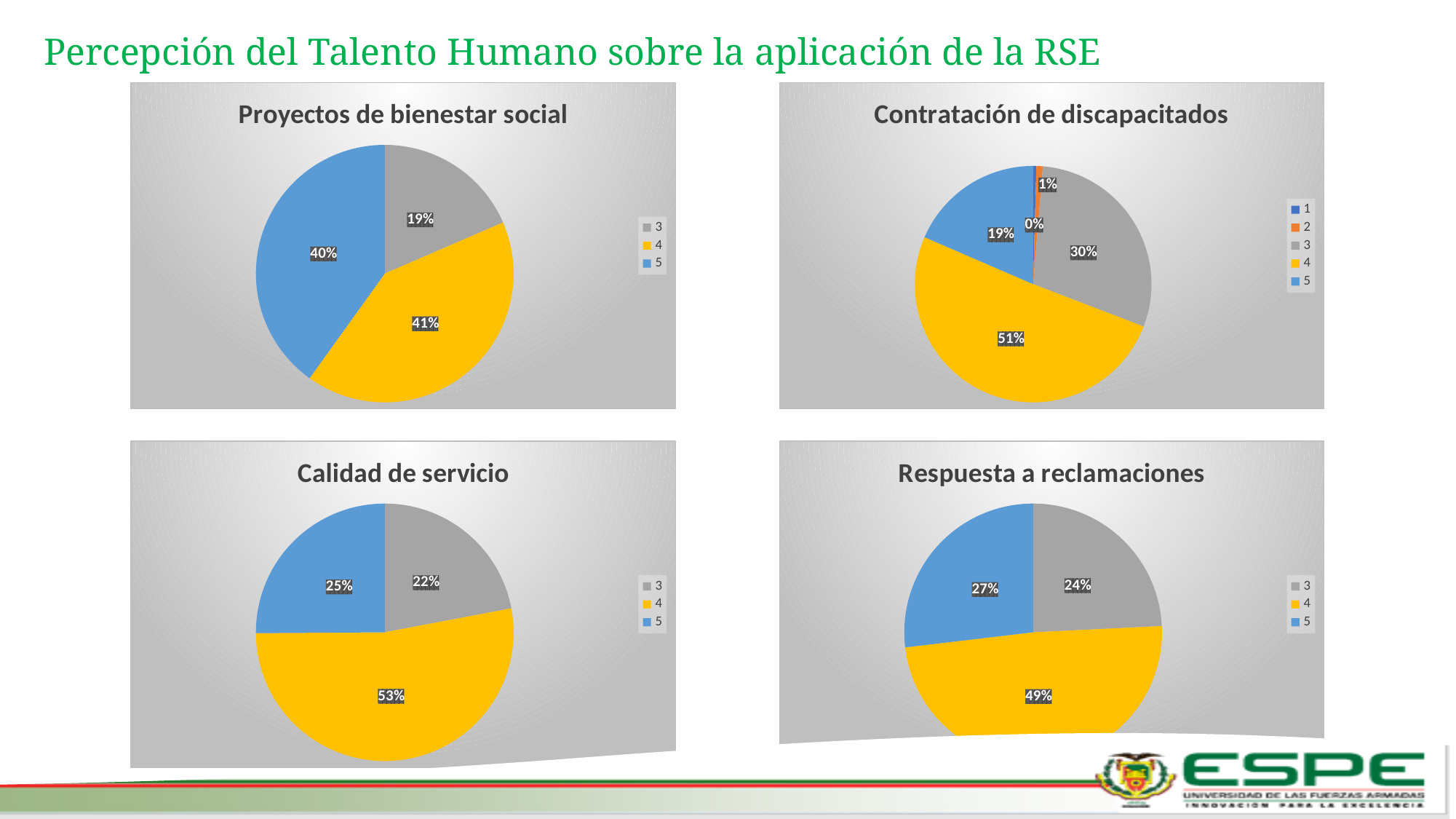
In the 'Calidad de servicio' chart, what share does category 5 have? 25% In the 'Calidad de servicio' chart, which is larger, the share of category 3 or category 5? 5 How many entries does the legend of the 'Contratación de discapacitados' chart list? 5 In the 'Contratación de discapacitados' chart, which category has the largest share? 4 In the 'Respuesta a reclamaciones' chart, what share does category 4 have? 49% In the 'Proyectos de bienestar social' chart, what share does category 3 have? 19% What type of chart is 'Calidad de servicio'? Pie chart In the 'Respuesta a reclamaciones' chart, what is the difference between the shares of category 5 and category 3? 3% In the 'Contratación de discapacitados' chart, what is the difference between the shares of category 3 and category 5? 11% In the 'Proyectos de bienestar social' chart, what share does category 4 have? 41% In the 'Contratación de discapacitados' chart, what share does category 4 have? 51% In the 'Proyectos de bienestar social' chart, which category has the smallest share? 3